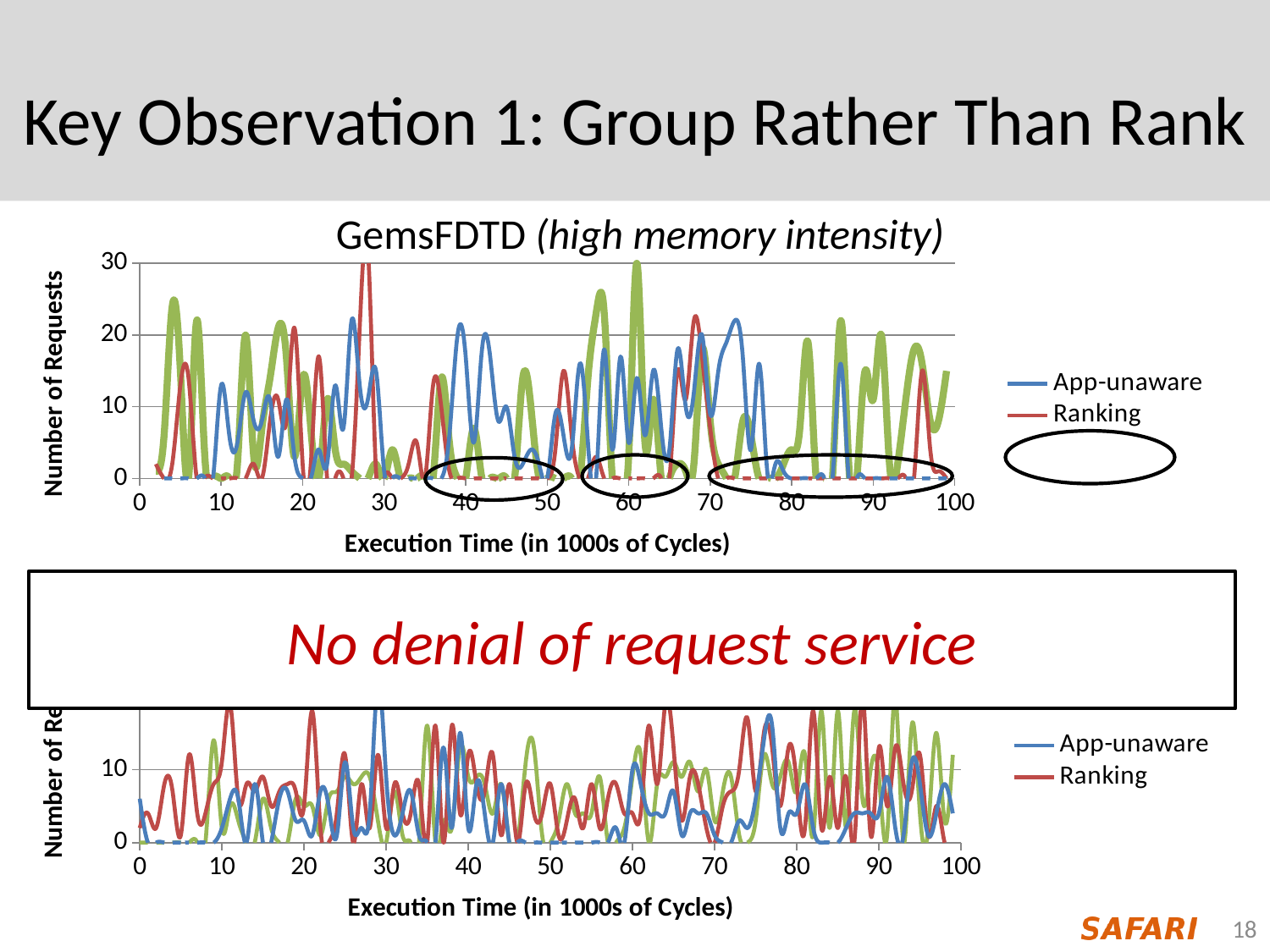
In the bottom chart, is the peak of the Ranking series near x = 10 greater or less than 10? greater How many tick labels are shown on the x-axis of the bottom chart? 11 What is the highest value shown on the y-axis of the top chart? 30 How many series does the legend of the bottom chart list? 2 What are the legend entries of the bottom chart? App-unaware, Ranking What is the y-axis label of the top chart? Number of Requests What is the title of the top chart? GemsFDTD (high memory intensity) What kind of chart is the bottom chart on the slide? line chart In the top chart, is the Ranking value at x = 85 greater or less than 10? less What is the x-axis label of the top chart? Execution Time (in 1000s of Cycles) What kind of chart is the top chart titled GemsFDTD (high memory intensity)? line chart